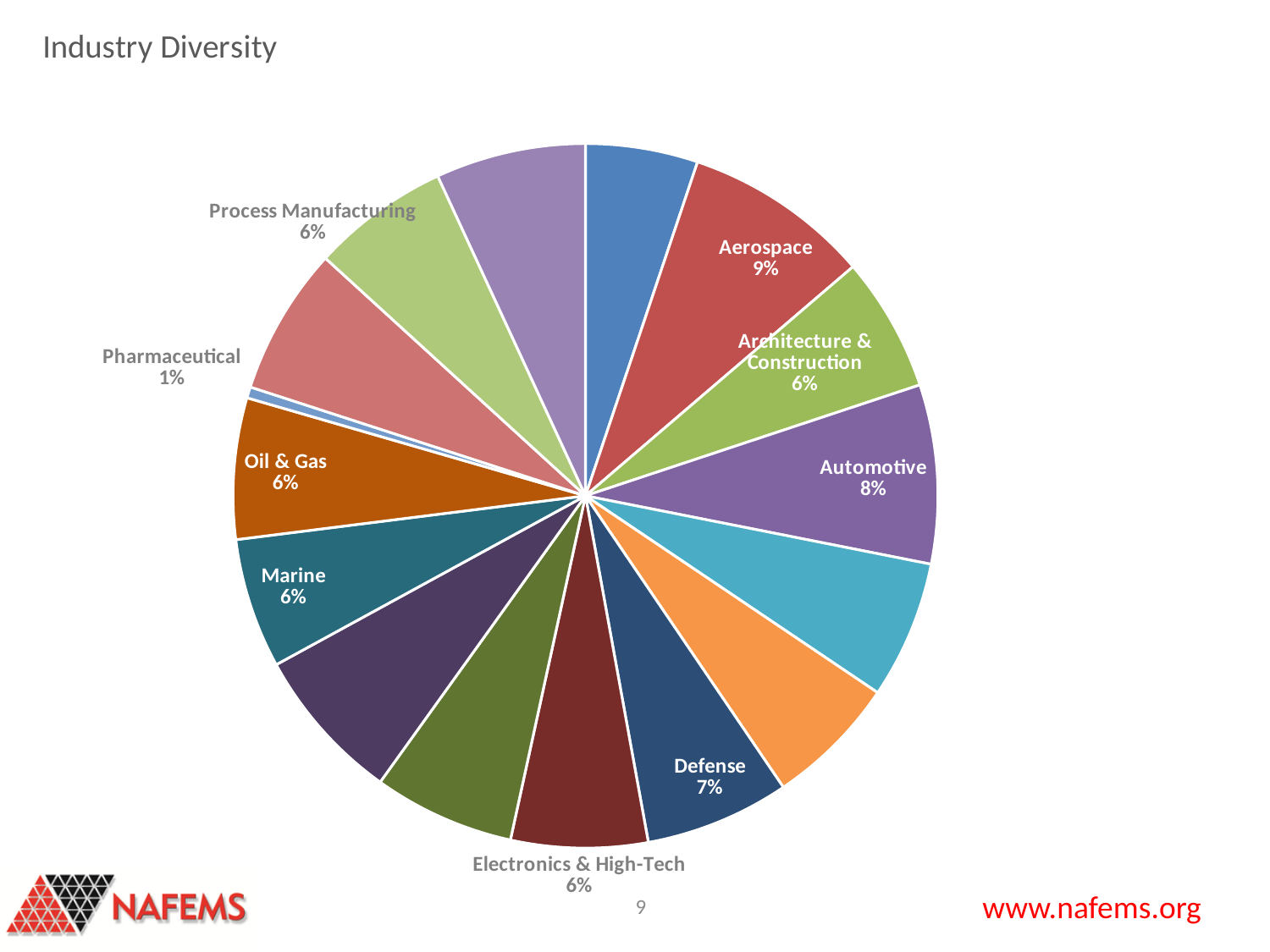
What percentage is shown for Electronics & High-Tech? 6% How many slices does the pie chart have? 16 What share of the pie does Aerospace represent? 9% What is the title of the chart? Industry Diversity What percentage is shown for Automotive? 8% Which is larger, the Aerospace slice or the Defense slice? Aerospace Which labeled industry has the smallest slice of the pie? Pharmaceutical What percentage is shown for Defense? 7% What kind of chart is shown on the slide? pie chart What is the difference in percentage points between Aerospace and Automotive? 1% What percentage is shown for Oil & Gas? 6% What percentage is shown for Pharmaceutical? 1%